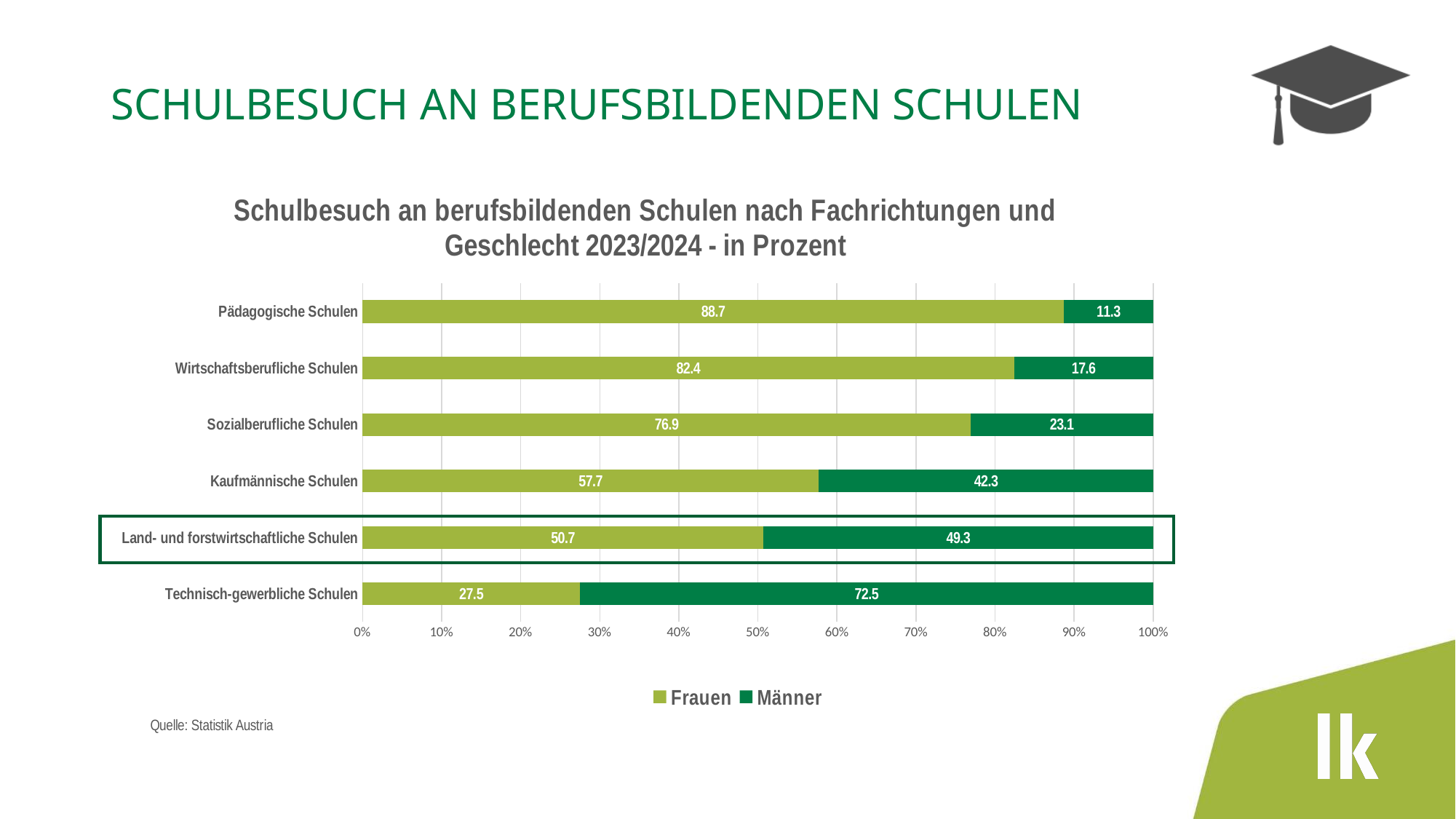
What source is cited below the chart? Statistik Austria Which category has the lowest Männer value? Pädagogische Schulen Which category has the highest Frauen value? Pädagogische Schulen What is the difference between the Frauen and Männer values for Kaufmännische Schulen? 15.4 What is the Männer value for Technisch-gewerbliche Schulen? 72.5 What is the Männer value for Land- und forstwirtschaftliche Schulen? 49.3 How many categories are shown on the chart? 6 What kind of chart is shown on the slide? Stacked bar chart What is the Frauen value for Pädagogische Schulen? 88.7 How many series does the legend list? 2 What is the total of the stacked bar for Wirtschaftsberufliche Schulen? 100 Which is larger for Sozialberufliche Schulen, the Frauen value or the Männer value? Frauen